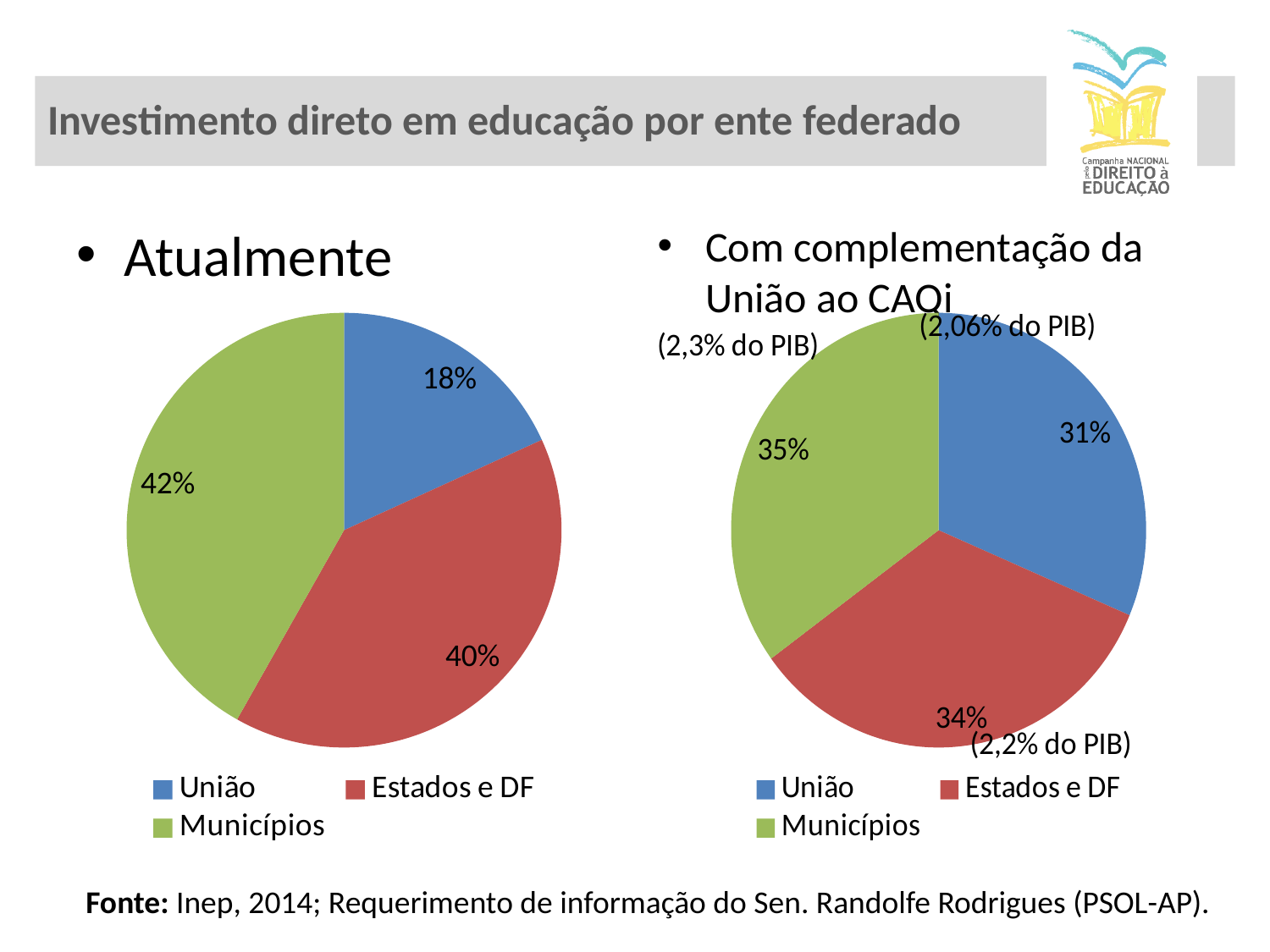
In the 'Com complementação da União ao CAQi' pie chart, what share does União have? 31% How many entries does the legend of the 'Atualmente' pie chart list? 3 In the 'Atualmente' pie chart, what share do Municípios have? 42% What type of chart is used on the left side of the slide under 'Atualmente'? Pie chart In the 'Com complementação da União ao CAQi' pie chart, what share do Estados e DF have? 34% In the 'Com complementação da União ao CAQi' pie chart, which is larger, the share of União or the share of Municípios? Municípios In the 'Com complementação da União ao CAQi' pie chart, what share do Municípios have? 35% In the 'Atualmente' pie chart, what is the difference between the shares of Municípios and União? 24% In the 'Atualmente' pie chart, what share does União have? 18% In the 'Atualmente' pie chart, which category has the smallest share? União In the 'Atualmente' pie chart, which category has the largest share? Municípios In the 'Atualmente' pie chart, what share do Estados e DF have? 40%